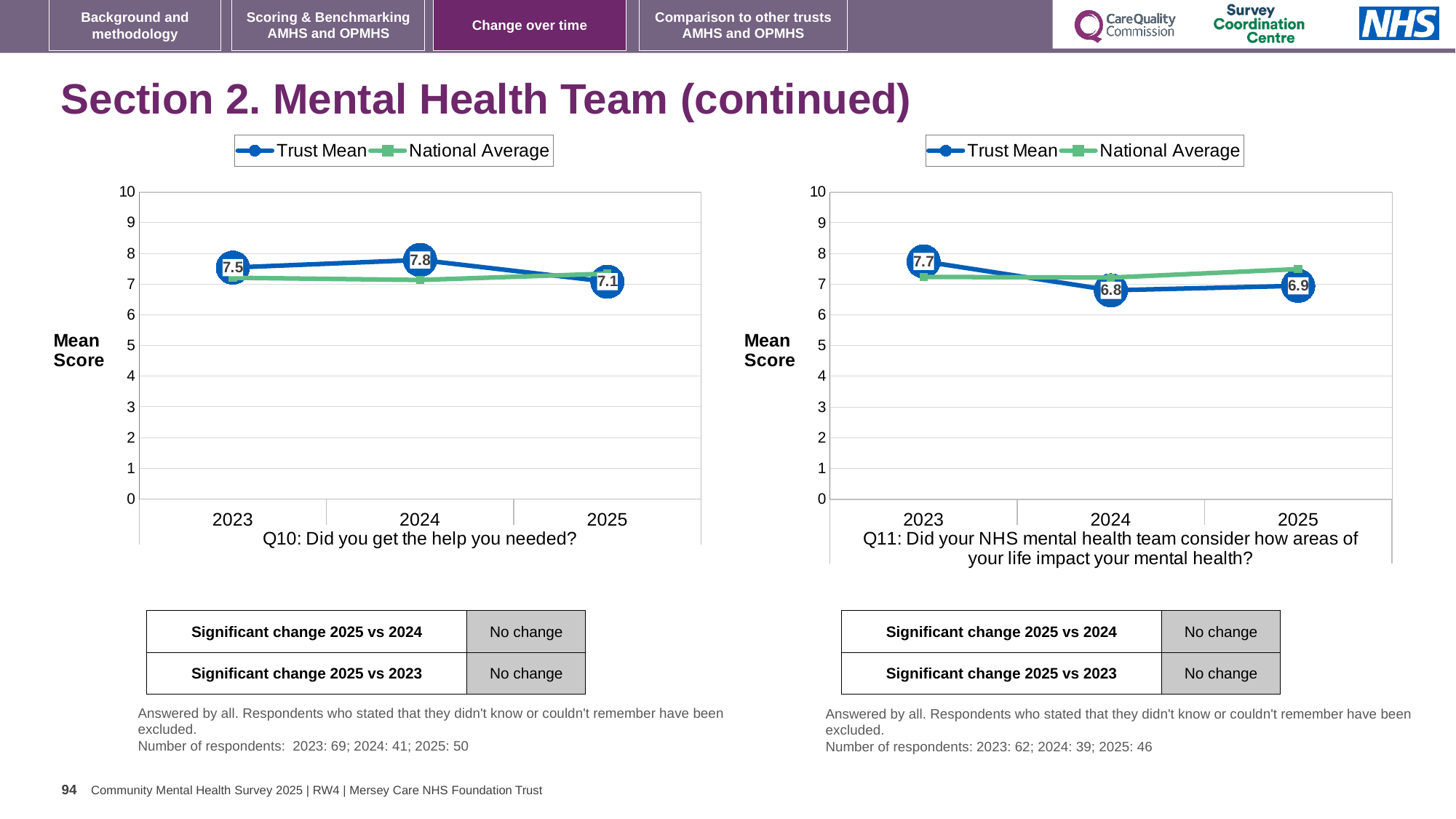
On the Q11 chart (right), is the Trust Mean higher in 2023 or in 2025? 2023 How many series does the legend of the Q10 chart (left) list? 2 On the Q10 chart (left), what is the difference between the Trust Mean in 2024 and in 2025? 0.7 What kind of chart is the Q11 chart (right)? Line chart On the Q10 chart (left), which year has the highest Trust Mean? 2024 On the Q11 chart (right), what is the difference between the Trust Mean in 2023 and in 2024? 0.9 On the Q10 chart (left), what is the Trust Mean for 2024? 7.8 On the Q10 chart (left), what is the Trust Mean for 2025? 7.1 On the Q11 chart (right), which year has the lowest Trust Mean? 2024 On the Q11 chart (right), what is the Trust Mean for 2023? 7.7 On the Q11 chart (right), what is the Trust Mean for 2024? 6.8 On the Q11 chart (right), is the National Average for 2025 greater or less than 7? greater